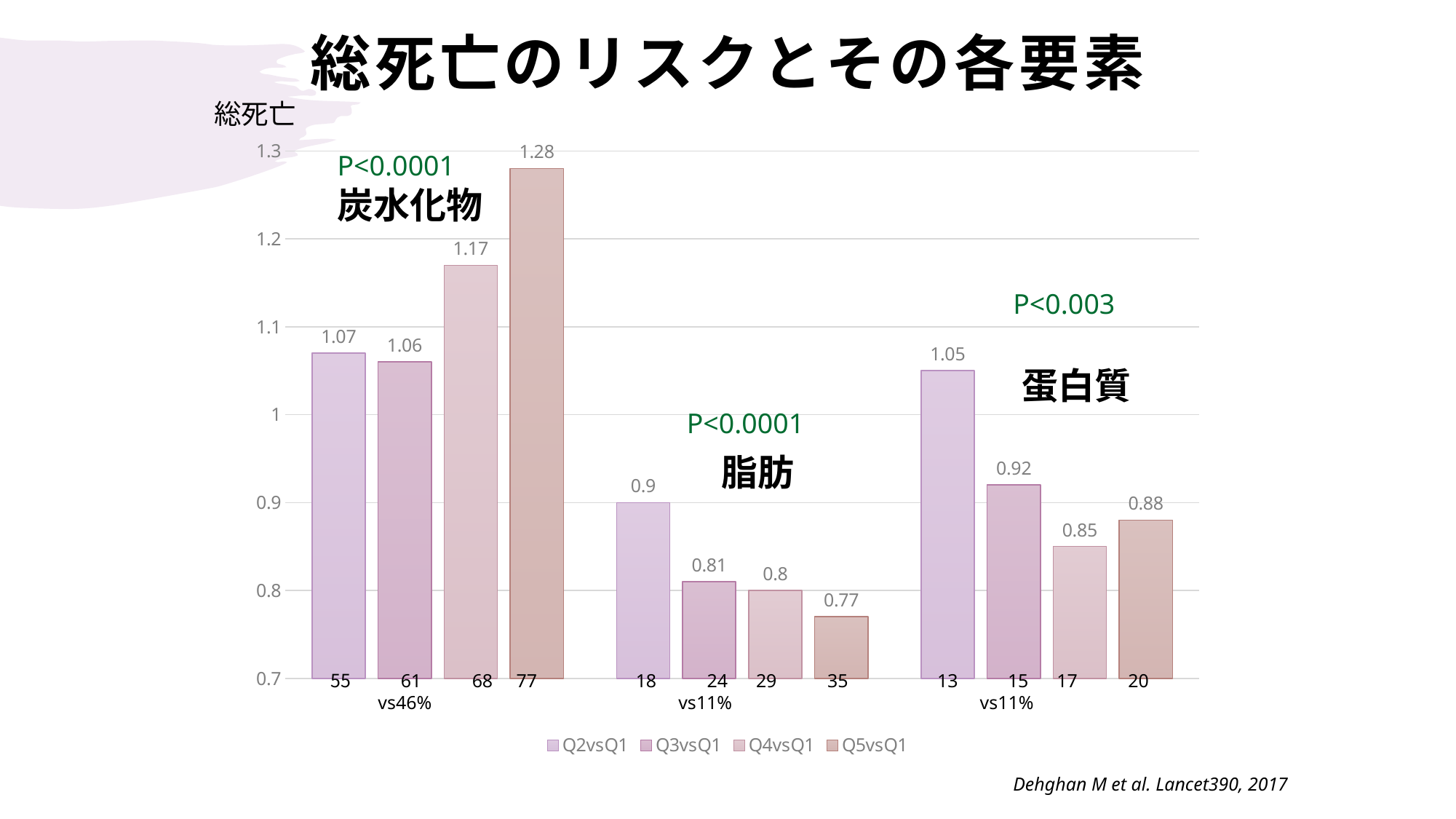
What kind of chart is shown on the slide? Bar chart Which bar in the 炭水化物 (carbohydrate) group has the highest value? Q5vsQ1 Which is larger: the Q5vsQ1 value for 蛋白質 (protein) or the Q5vsQ1 value for 脂肪 (fat)? 蛋白質 (protein) What is the value of the Q2vsQ1 bar for 脂肪 (fat)? 0.9 What is the value of the Q5vsQ1 bar for 炭水化物 (carbohydrate)? 1.28 What is the difference between the Q2vsQ1 and Q5vsQ1 values for 脂肪 (fat)? 0.13 What P value is shown for the 蛋白質 (protein) group? P<0.003 What is the value of the Q4vsQ1 bar for 蛋白質 (protein)? 0.85 How many series does the legend list? 4 Which bar in the 脂肪 (fat) group has the lowest value? Q5vsQ1 Do the values in the 脂肪 (fat) group rise or fall from Q2vsQ1 to Q5vsQ1? Fall What is the difference between the Q5vsQ1 and Q2vsQ1 values for 炭水化物 (carbohydrate)? 0.21